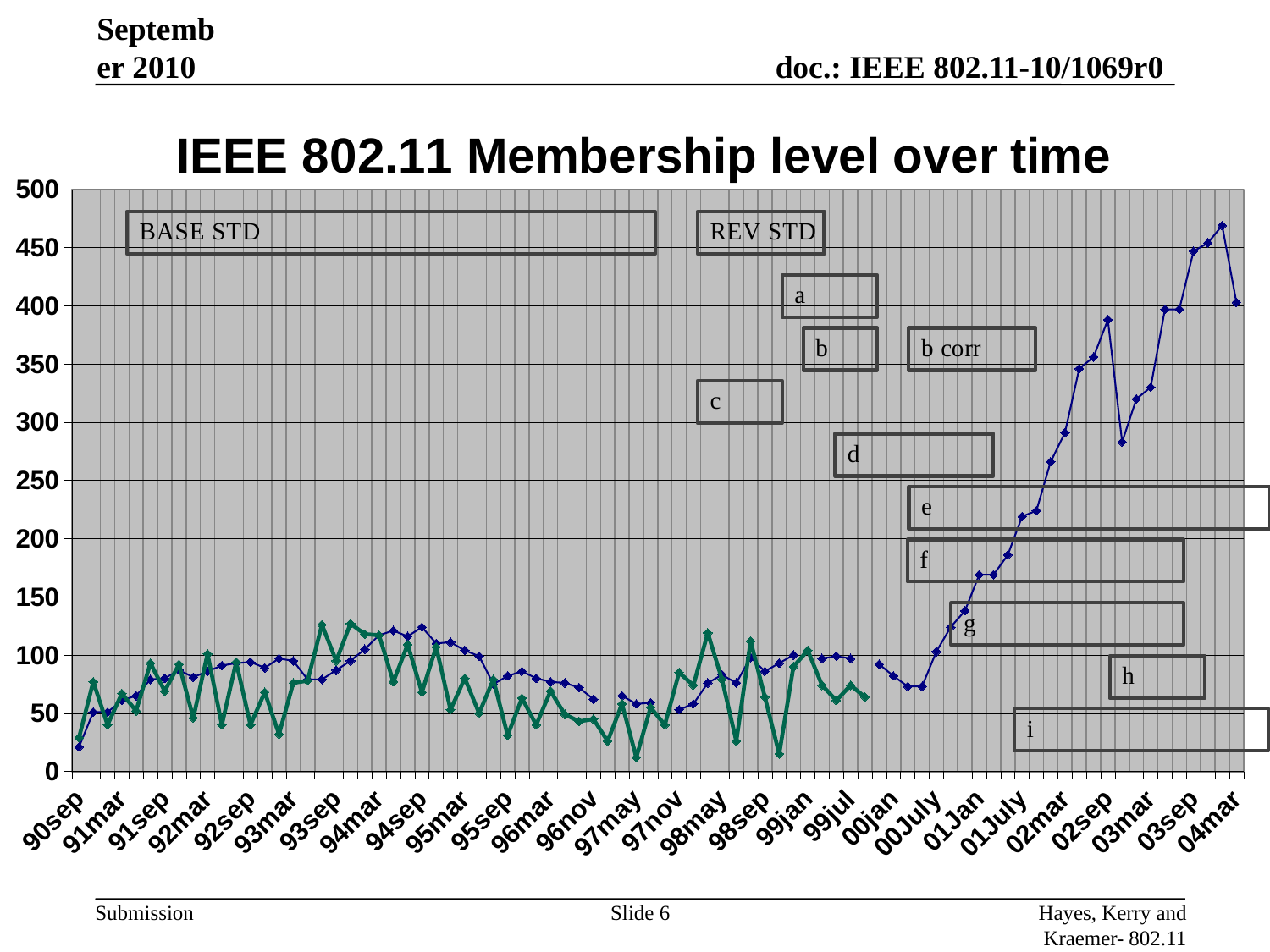
Is the value of the blue line at 03sep greater or less than 400? greater Is the value of the green line at 97may greater or less than 50? less Is the value of the blue line at 04mar greater or less than 350? greater Does the blue line rise or fall between 00jan and 03sep? rise How many labelled categories are shown on the x axis? 28 Which has the larger value on the blue line, 02sep or 02mar? 02sep What kind of chart is shown on the slide? line chart What is the highest value shown on the y axis? 500 What is the title of the chart? IEEE 802.11 Membership level over time